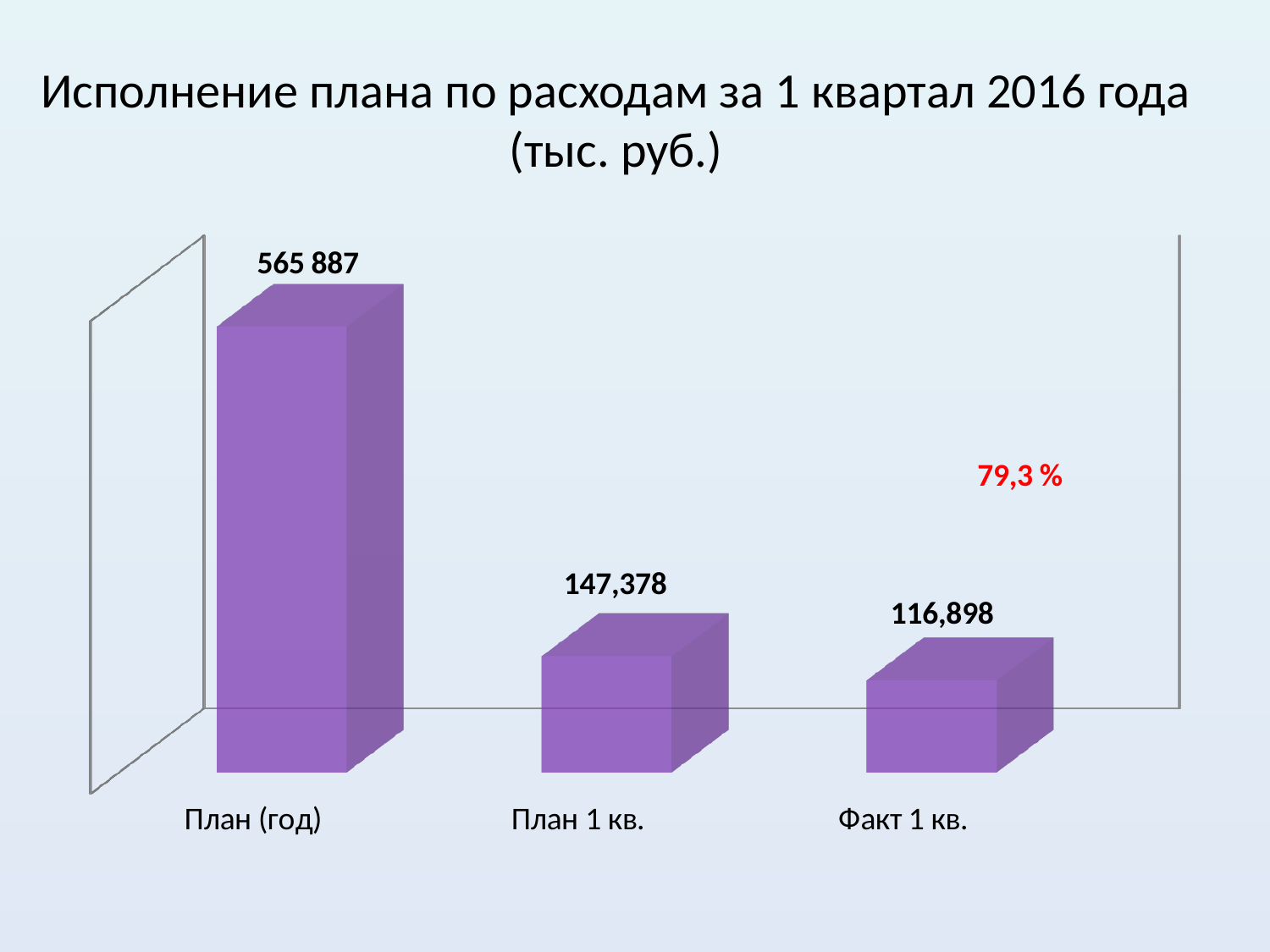
What kind of chart is shown on the slide? Bar chart How many categories are shown in the chart? 3 Do the values rise or fall from left to right across the categories? Fall Which category has the lowest value? Факт 1 кв. What is the value for Факт 1 кв.? 116,898 Which is larger, the value for План (год) or the value for План 1 кв.? План (год) Which is larger, the value for План 1 кв. or the value for Факт 1 кв.? План 1 кв. Which category has the highest value? План (год) What is the difference between the values for План 1 кв. and Факт 1 кв.? 30,480 What percentage is shown in red on the chart? 79,3 % What is the value for План (год)? 565 887 What is the value for План 1 кв.? 147,378